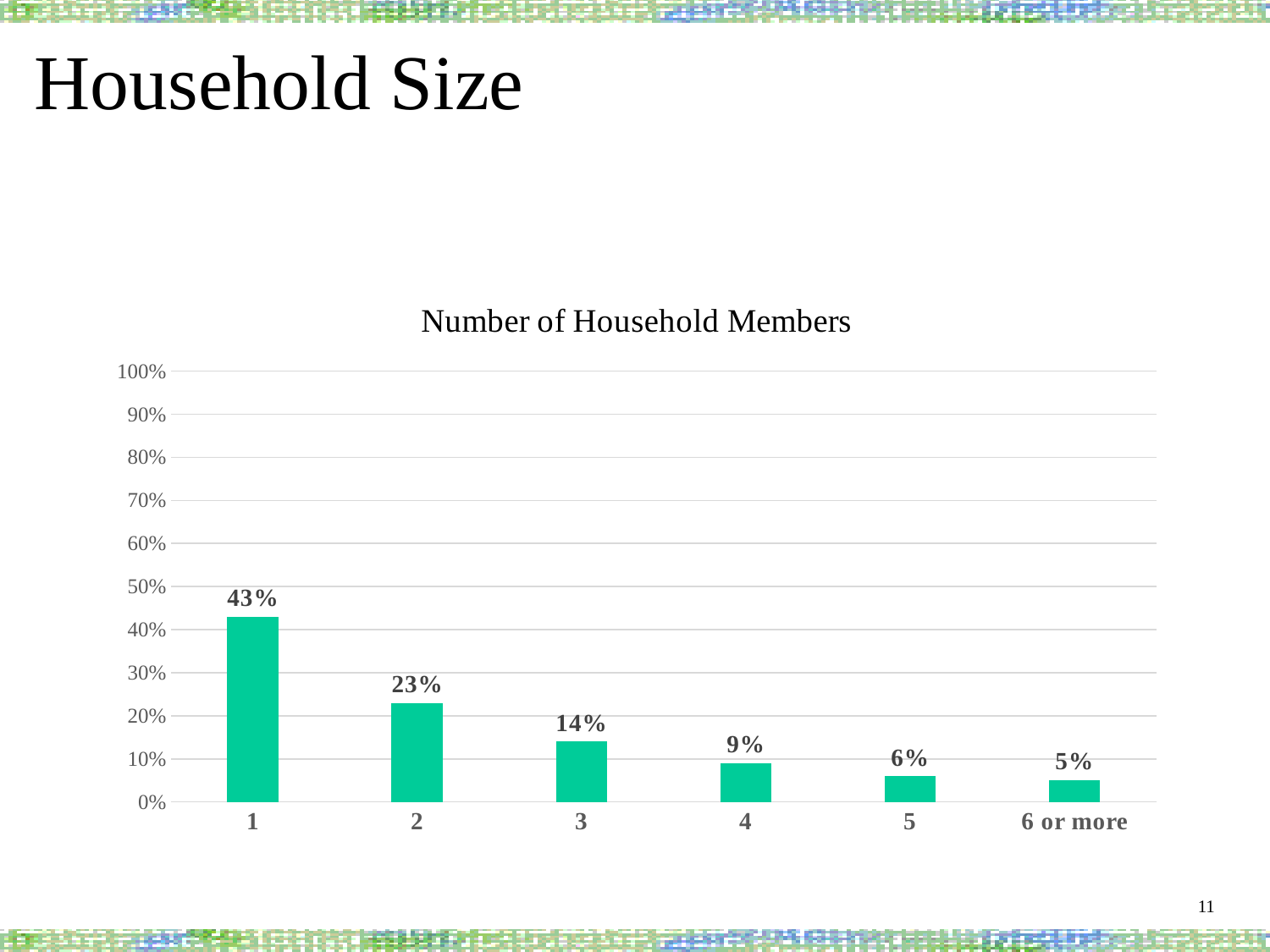
Is the value for 1-member households greater or less than 40%? greater What percentage is shown for the '6 or more' category? 5% What kind of chart is shown on the slide? bar chart What is the value shown for households with 3 members? 14% What percentage of households have 1 member? 43% Which is larger, the value for 2-member households or 3-member households? 2-member households Which household size category has the lowest percentage? 6 or more Do the values rise or fall as household size increases along the x axis? fall What is the difference between the percentage for 1-member households and 2-member households? 20% What is the difference between the values for 4-member and 5-member households? 3% Which household size category has the highest percentage? 1 How many household size categories are shown on the x axis? 6